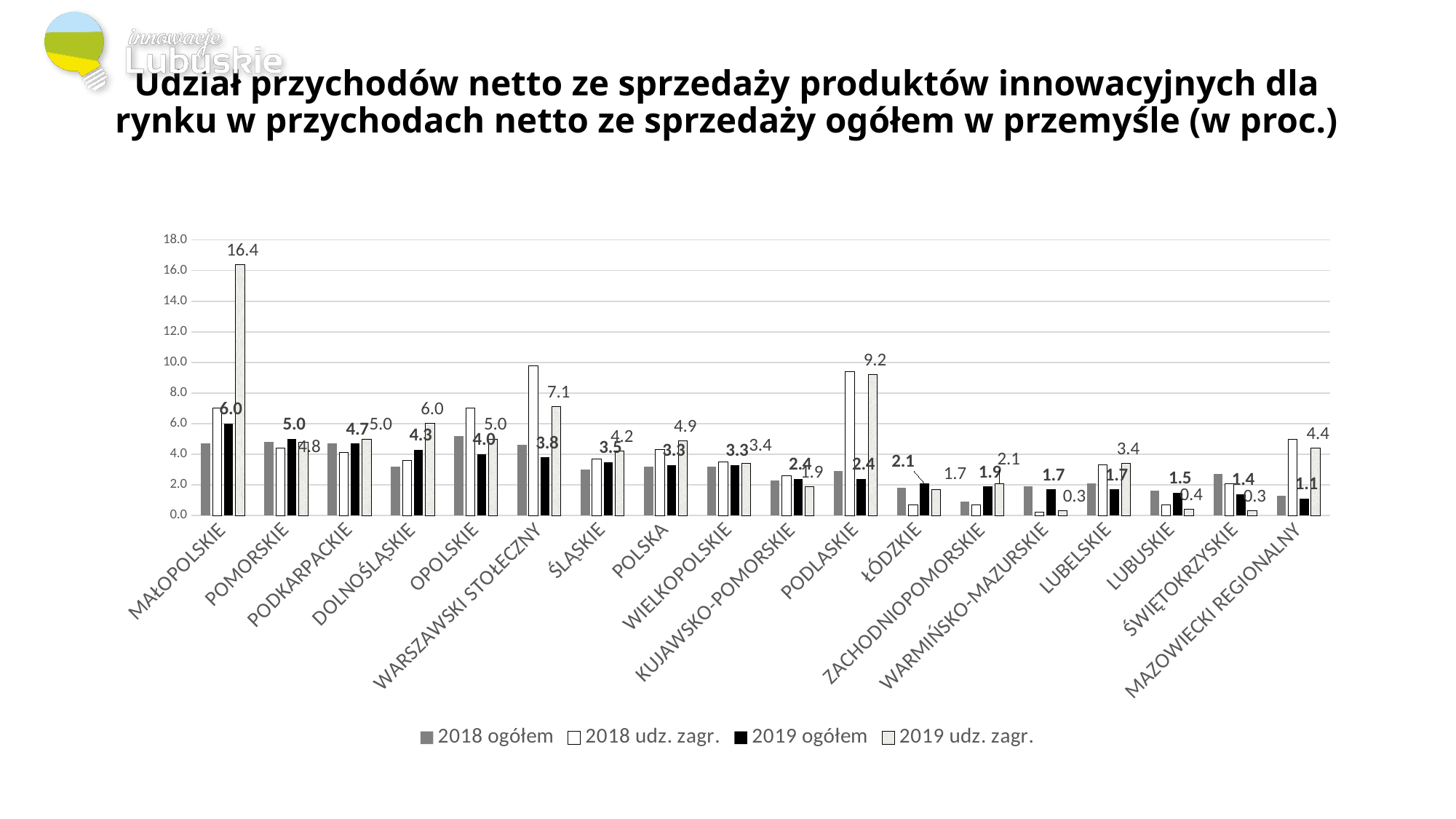
What is the value of the 2019 udz. zagr. series for MAŁOPOLSKIE? 16.4 For MAŁOPOLSKIE, what is the difference between the 2019 udz. zagr. value and the 2019 ogółem value? 10.4 Which category has the highest value in the 2019 udz. zagr. series? MAŁOPOLSKIE Is the 2018 udz. zagr. value for PODLASKIE greater or less than 8.0? greater What is the value of the 2019 ogółem series for POLSKA? 3.3 How many series does the legend list? 4 For PODLASKIE, what is the difference between the 2019 udz. zagr. value and the 2019 ogółem value? 6.8 In the 2019 udz. zagr. series, which is larger: WARSZAWSKI STOŁECZNY or DOLNOŚLĄSKIE? WARSZAWSKI STOŁECZNY Which category has the lowest value in the 2019 ogółem series? MAZOWIECKI REGIONALNY How many categories are shown on the x axis of the chart? 18 What is the value of the 2019 ogółem series for LUBUSKIE? 1.5 What is the value of the 2019 udz. zagr. series for PODLASKIE? 9.2